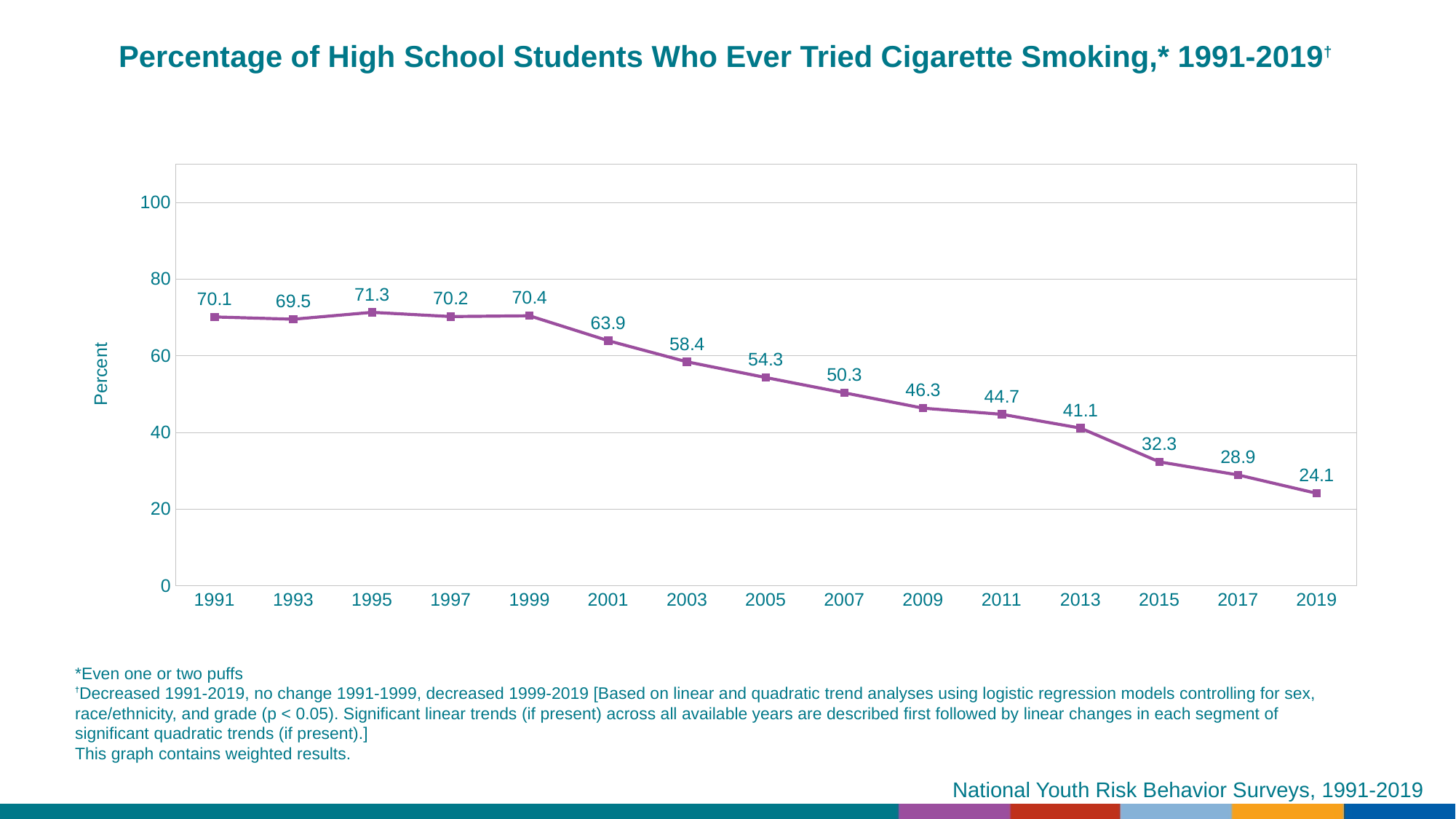
Which year has the highest percentage? 1995 Which year has a larger value, 2001 or 2005? 2001 What was the percentage of high school students who ever tried cigarette smoking in 1991? 70.1 What kind of chart is shown on the slide? Line chart Which year has the lowest percentage? 2019 What value is shown for 2007? 50.3 Is the value for 2011 greater or less than 40? greater How many years are plotted on the chart? 15 What is the difference between the values for 2013 and 2015? 8.8 What is the difference between the values for 1991 and 2019? 46 Do the values generally rise or fall from 1999 to 2019? Fall What was the percentage of high school students who ever tried cigarette smoking in 2019? 24.1